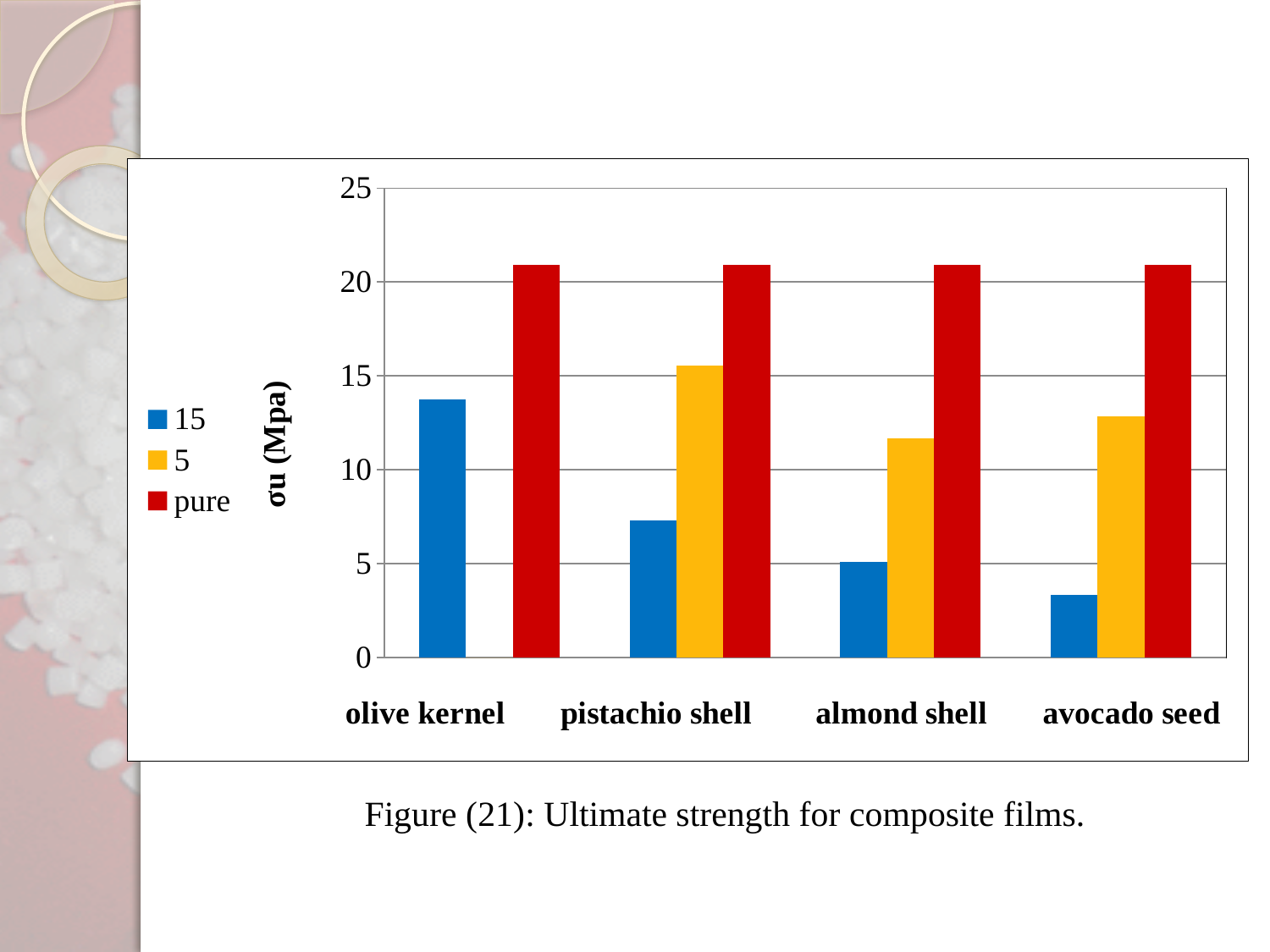
Which category has the highest value for the 15 series? olive kernel Is the value for avocado seed in the 15 series greater or less than 5? less Which category has the highest value for the 5 series? pistachio shell How many series does the chart's legend list? 3 Is the value for pure in the almond shell category greater or less than 15? greater Which is larger in the 15 series: pistachio shell or almond shell? pistachio shell Is the value for almond shell in the 15 series greater or less than 10? less How many categories are shown on the x axis of the chart? 4 What is the label on the y axis of the chart? σu (Mpa) What kind of chart is shown on the slide? bar chart Which category has the lowest value for the 15 series? avocado seed